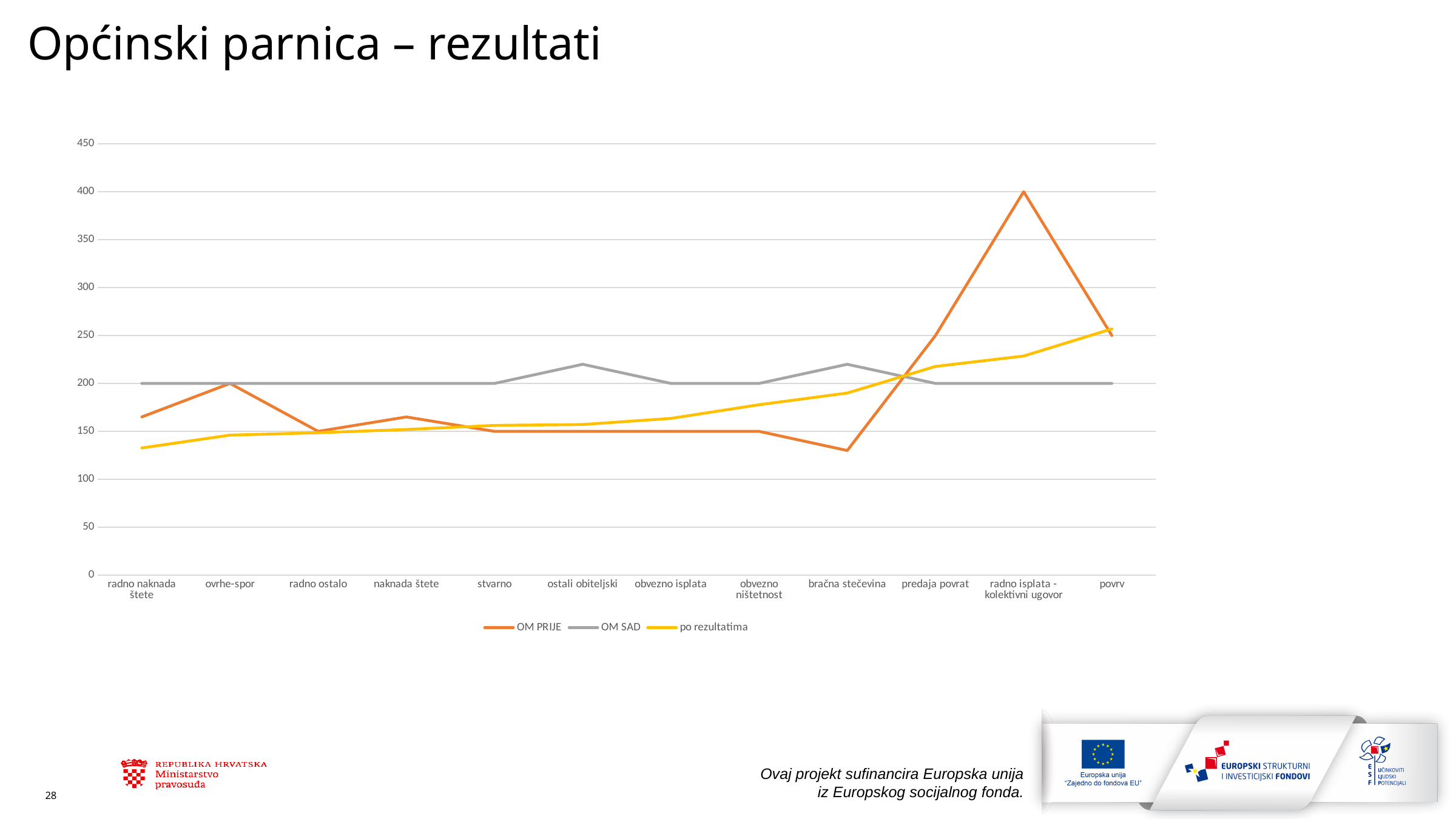
For which category is OM PRIJE lowest? bračna stečevina For which category is OM PRIJE highest? radno isplata - kolektivni ugovor What is the value of OM PRIJE for ovrhe-spor? 200 Is the value of po rezultatima for radno naknada štete greater or less than 150? less What is the value of OM SAD for radno naknada štete? 200 Does the po rezultatima series generally rise or fall from left to right? rise What is the value of OM PRIJE for radno isplata - kolektivni ugovor? 400 What kind of chart is shown on the slide? line chart How many series does the legend list? 3 Is the value of OM SAD for ostali obiteljski greater or less than 200? greater How many categories are shown on the x axis? 12 Which is larger for bračna stečevina: OM PRIJE or OM SAD? OM SAD